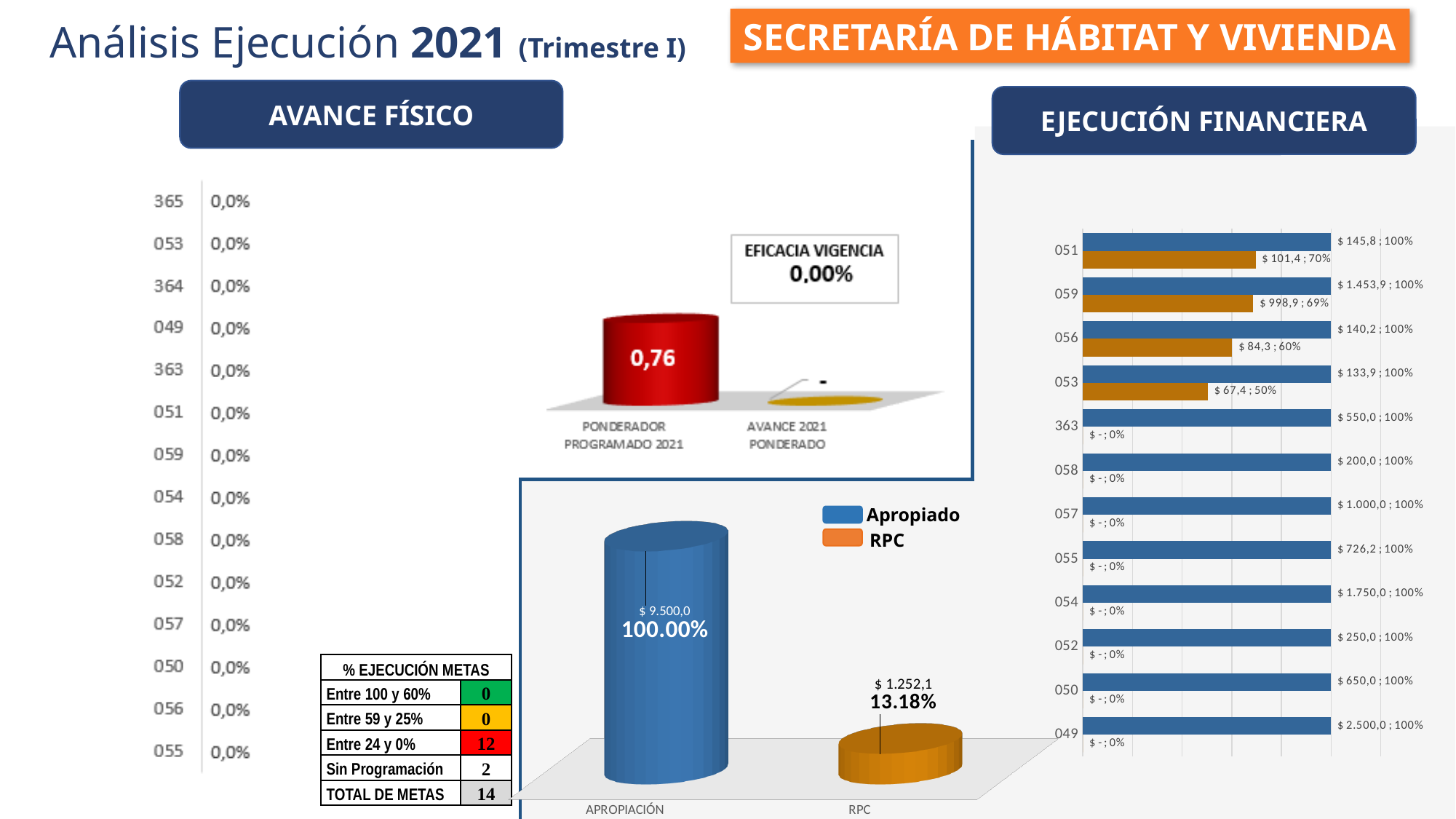
In the right-hand horizontal bar chart, how many codes are listed on the vertical axis? 12 In the right-hand horizontal bar chart, what RPC percentage is shown for code 053? 50% In the EFICACIA VIGENCIA chart, what percentage is shown in the EFICACIA VIGENCIA box? 0.00% In the right-hand horizontal bar chart, what is the Apropiado value for code 059? $ 1.453,9 In the bottom-center cylinder chart, which is larger, APROPIACIÓN or RPC? APROPIACIÓN In the bottom-center cylinder chart, what percentage is shown for RPC? 13.18% What type of chart is shown on the right-hand side under EJECUCIÓN FINANCIERA? Bar chart In the EFICACIA VIGENCIA chart, what value is shown on the PONDERADOR PROGRAMADO 2021 cylinder? 0,76 In the bottom-center cylinder chart, what value is labelled on the APROPIACIÓN bar? $ 9.500,0 In the bottom-center cylinder chart, how many series does the legend list? 2 In the right-hand horizontal bar chart, what is the RPC value and percentage for code 051? $ 101,4 ; 70% In the right-hand horizontal bar chart, which code has the highest Apropiado value? 049